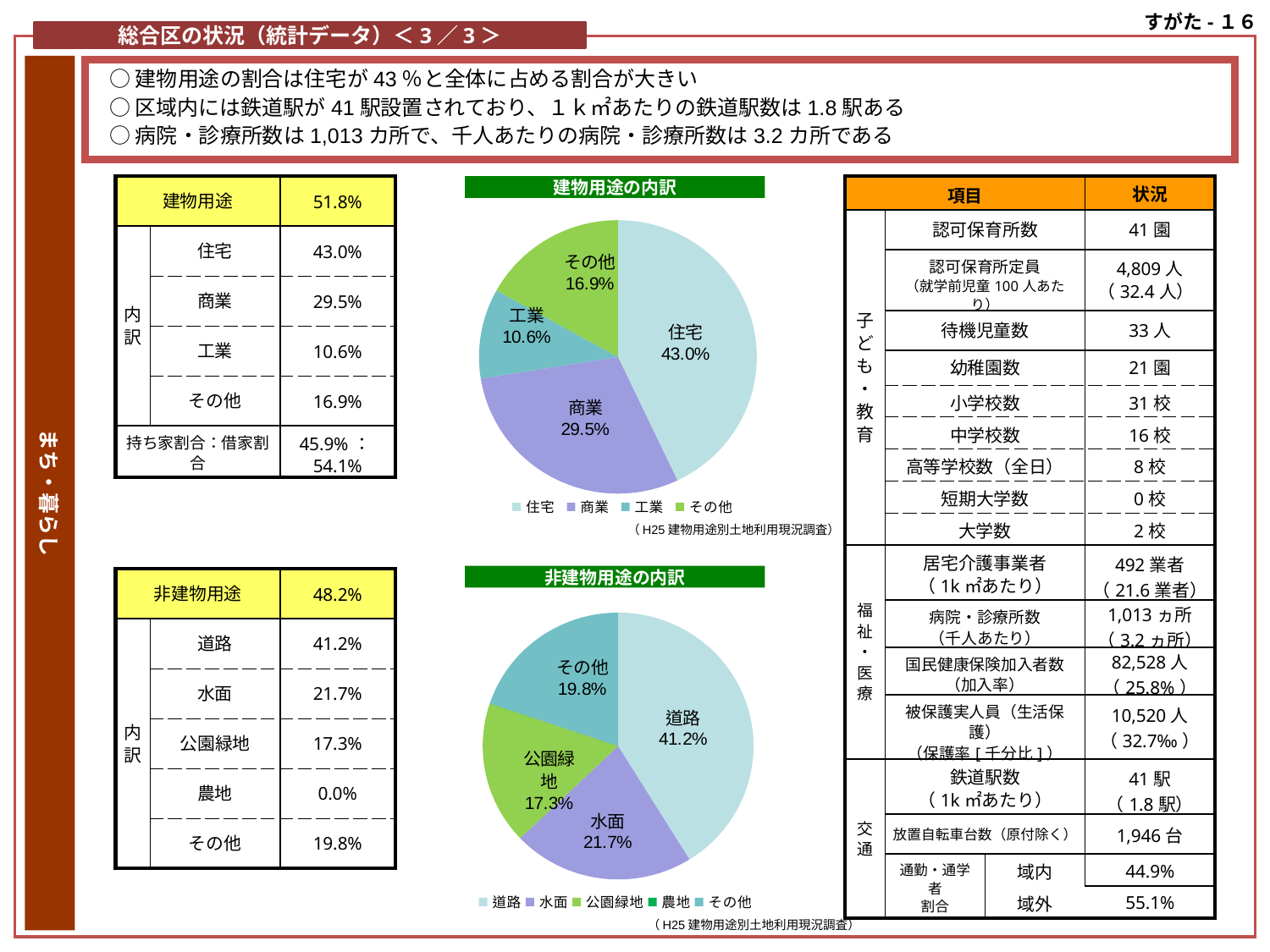
What kind of chart is the 非建物用途の内訳 chart? Pie chart In the 建物用途の内訳 pie chart, which category has the largest share? 住宅 In the 建物用途の内訳 pie chart, what is the difference between the shares of 住宅 and 商業? 13.5% In the 建物用途の内訳 pie chart, what is the share for 住宅? 43.0% In the 非建物用途の内訳 pie chart, what is the difference between the shares of 道路 and 水面? 19.5% In the 建物用途の内訳 pie chart, how many entries does the legend list? 4 In the 建物用途の内訳 pie chart, what is the share for 工業? 10.6% In the 非建物用途の内訳 pie chart, how many entries does the legend list? 5 In the 建物用途の内訳 pie chart, which category has the smallest share? 工業 In the 非建物用途の内訳 pie chart, which is larger, 水面 or その他? 水面 In the 非建物用途の内訳 pie chart, what is the share for 道路? 41.2% In the 非建物用途の内訳 pie chart, what is the share for 公園緑地? 17.3%